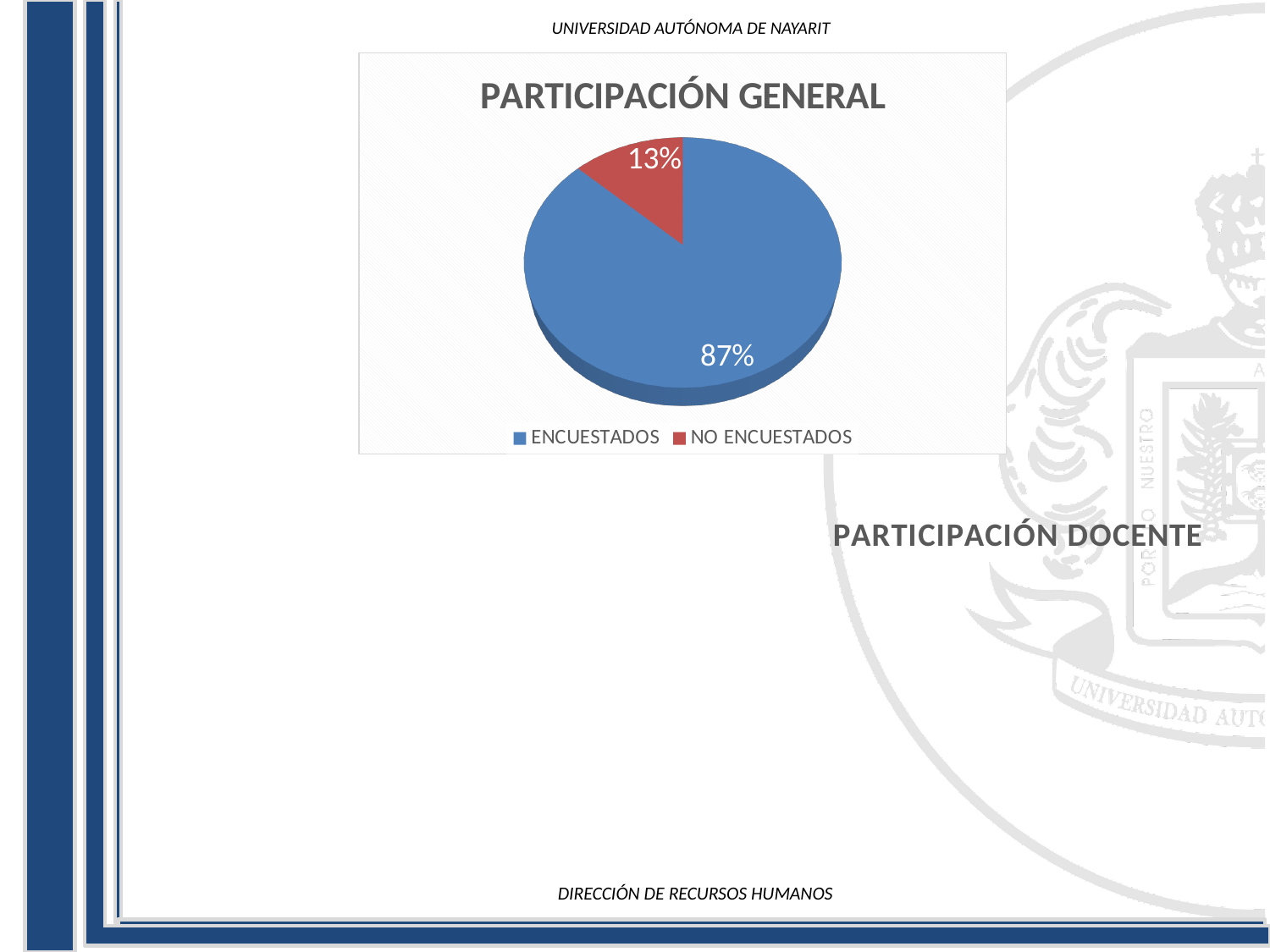
Which category has the largest slice of the pie? ENCUESTADOS What share of the pie does ENCUESTADOS represent? 87% How many entries does the legend list? 2 What colour is the NO ENCUESTADOS slice? Red Which category has the smallest slice of the pie? NO ENCUESTADOS How many slices does the pie chart have? 2 What share of the pie does NO ENCUESTADOS represent? 13% What is the title of the chart? PARTICIPACIÓN GENERAL Which is larger, the ENCUESTADOS slice or the NO ENCUESTADOS slice? ENCUESTADOS What is the difference in percentage points between ENCUESTADOS and NO ENCUESTADOS? 74 What kind of chart is shown on the slide? Pie chart